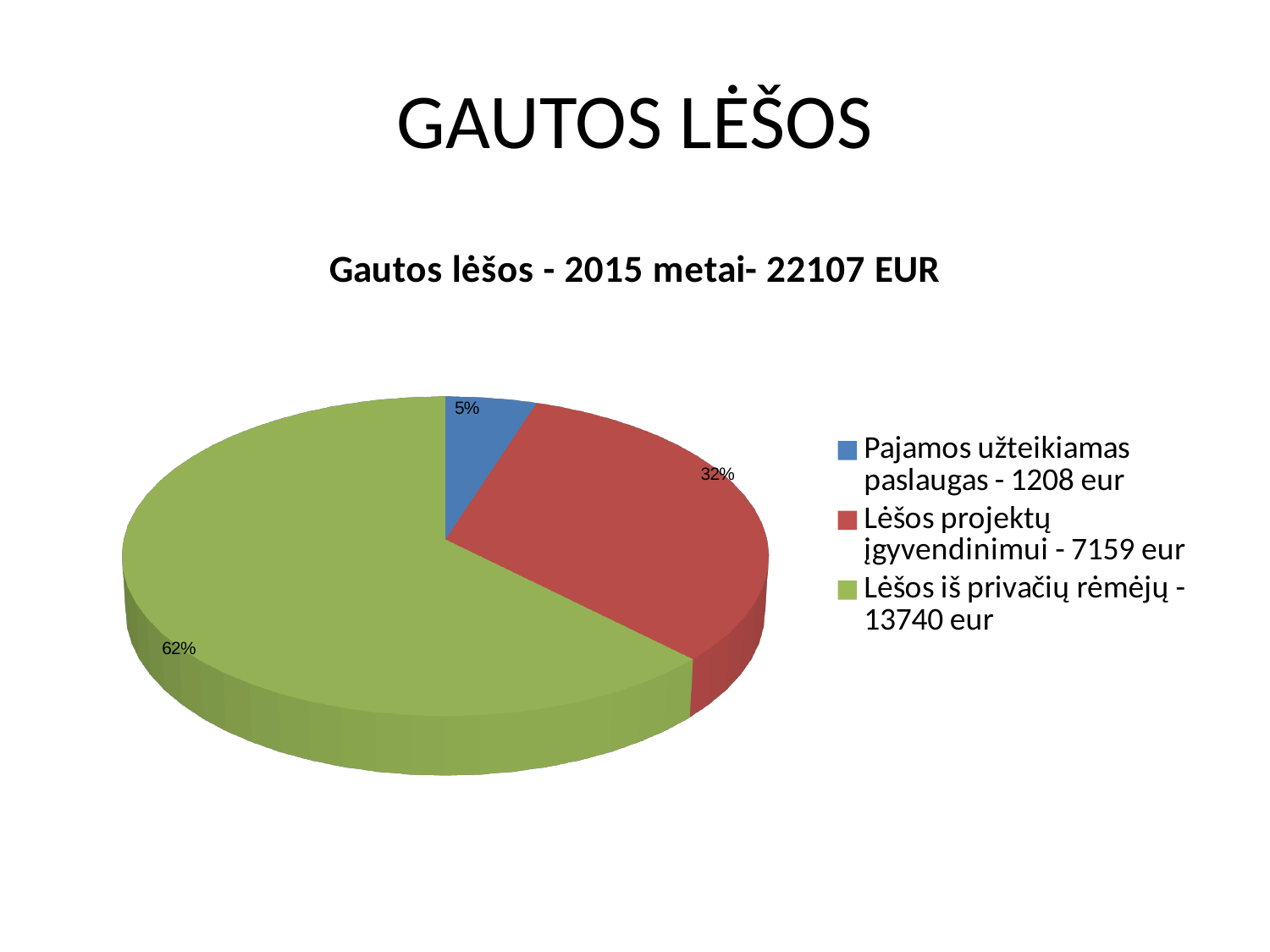
How many slices does the pie chart have? 3 Which category has the smallest slice of the pie? Pajamos užteikiamas paslaugas - 1208 eur Which category has the largest slice of the pie? Lėšos iš privačių rėmėjų - 13740 eur What is the difference in percentage points between the share for "Lėšos iš privačių rėmėjų" and the share for "Lėšos projektų įgyvendinimui"? 30 percentage points Which is larger: the share for "Lėšos projektų įgyvendinimui" or the share for "Pajamos užteikiamas paslaugas"? Lėšos projektų įgyvendinimui What colour is the slice for "Lėšos iš privačių rėmėjų - 13740 eur"? green What share of the pie does "Lėšos iš privačių rėmėjų - 13740 eur" represent? 62% What share of the pie does "Pajamos užteikiamas paslaugas - 1208 eur" represent? 5% What is the title of the chart? Gautos lėšos - 2015 metai- 22107 EUR According to the chart title, what is the total amount of funds received in 2015? 22107 EUR What share of the pie does "Lėšos projektų įgyvendinimui - 7159 eur" represent? 32% What kind of chart is shown on the slide? pie chart